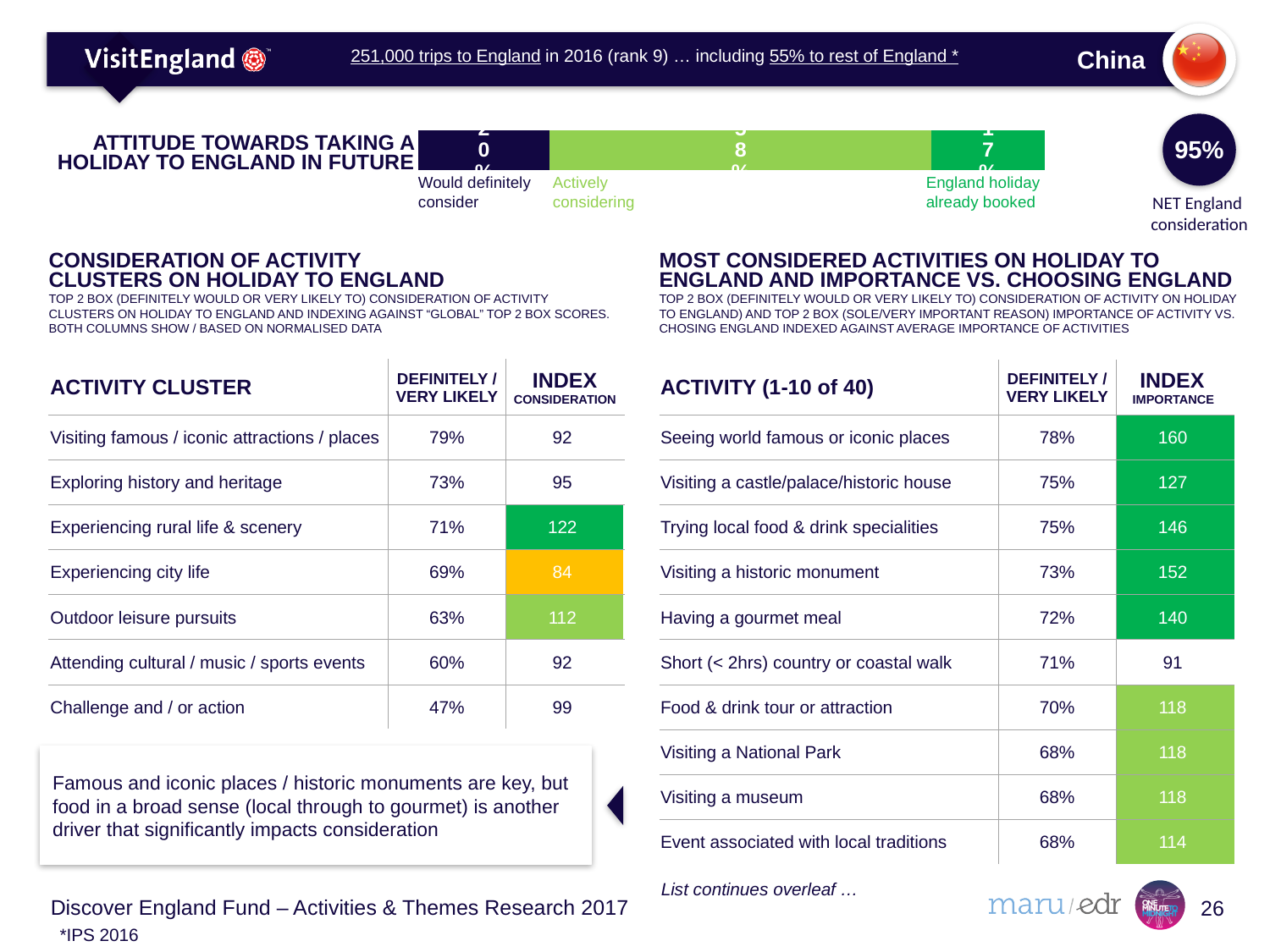
In the 'Attitude towards taking a holiday to England in future' bar, which is larger: 'Actively considering' or 'England holiday already booked'? Actively considering How many segments (categories) does the 'Attitude towards taking a holiday to England in future' bar have? 3 In the 'Most considered activities on holiday to England' table, what is the difference in 'Definitely / very likely' between 'Seeing world famous or iconic places' and 'Visiting a museum'? 10% In the 'Consideration of activity clusters on holiday to England' table, what is the 'Definitely / very likely' value for 'Experiencing rural life & scenery'? 71% In the 'Attitude towards taking a holiday to England in future' bar, which is larger: 'Actively considering' or 'Would definitely consider'? Actively considering What colour is the 'Actively considering' segment in the 'Attitude towards taking a holiday to England in future' bar? green What colour is the 'Would definitely consider' segment in the 'Attitude towards taking a holiday to England in future' bar? dark navy blue What NET England consideration figure is shown next to the 'Attitude towards taking a holiday to England in future' bar? 95% In the 'Most considered activities on holiday to England' table, what is the 'Index importance' for 'Seeing world famous or iconic places'? 160 What kind of chart is used for 'Attitude towards taking a holiday to England in future'? stacked bar chart In the 'Consideration of activity clusters on holiday to England' table, which activity cluster has the highest 'Index consideration'? Experiencing rural life & scenery Which segment of the 'Attitude towards taking a holiday to England in future' bar is the largest? Actively considering